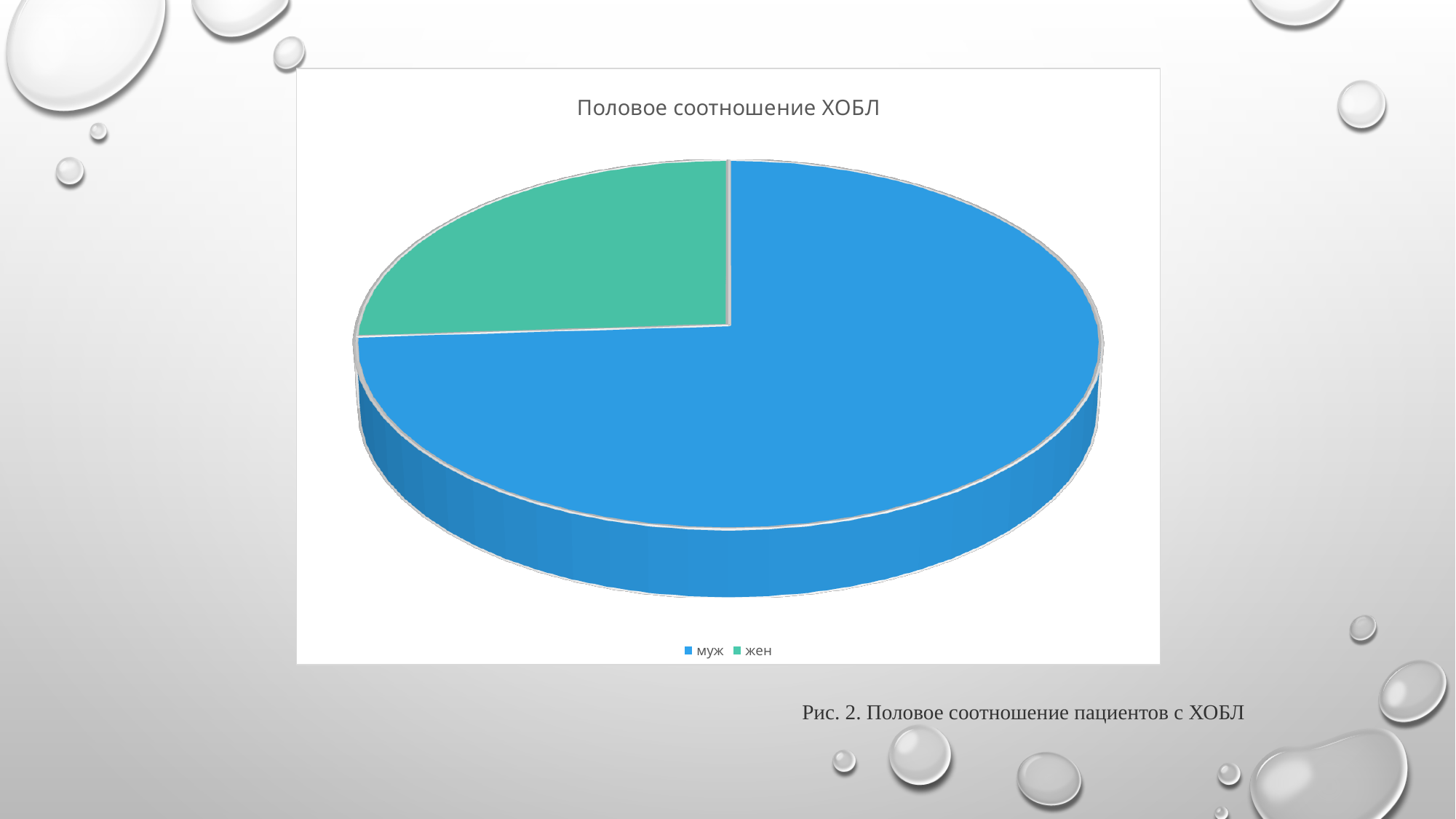
Which category has the smallest slice of the pie? жен How many entries does the legend list? 2 Which category has the largest slice of the pie? муж Which slice is larger, муж or жен? муж What colour is the slice for жен? green How many slices does the pie chart have? 2 What is the title of the chart? Половое соотношение ХОБЛ What kind of chart is shown on the slide? pie chart